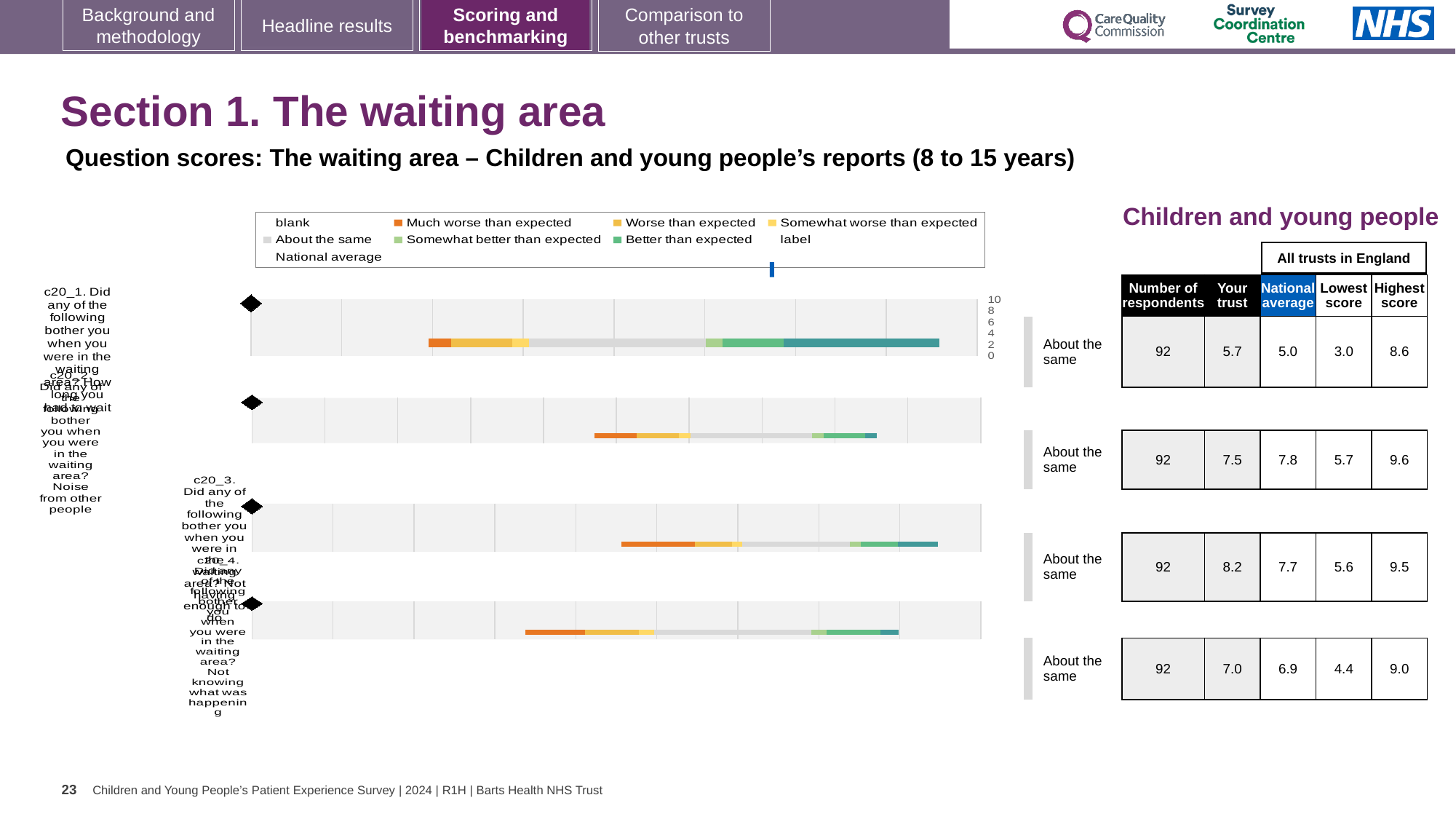
For the second chart from the top (c20_2), which is larger: the 'Your trust' score or the national average? national average What kind of chart is used to show the question scores on this slide? bar chart For the third chart from the top (c20_3), what is the highest score among all trusts in England? 9.5 For the bottom chart (c20_4), what is the lowest score among all trusts in England? 4.4 Which of the four charts has the lowest 'Your trust' score? the top chart (c20_1), 5.7 How many respondents are listed for the top chart (c20_1)? 92 For the top chart (c20_1), what is the difference between the 'Your trust' score and the national average? 0.7 What rating label is shown next to each of the four charts? About the same How many question charts are shown on the slide? 4 For the top chart (c20_1), what is the 'Your trust' score shown in the table? 5.7 For the second chart from the top (c20_2), what is the national average score? 7.8 Which of the four charts has the highest 'Your trust' score? the third chart (c20_3), 8.2